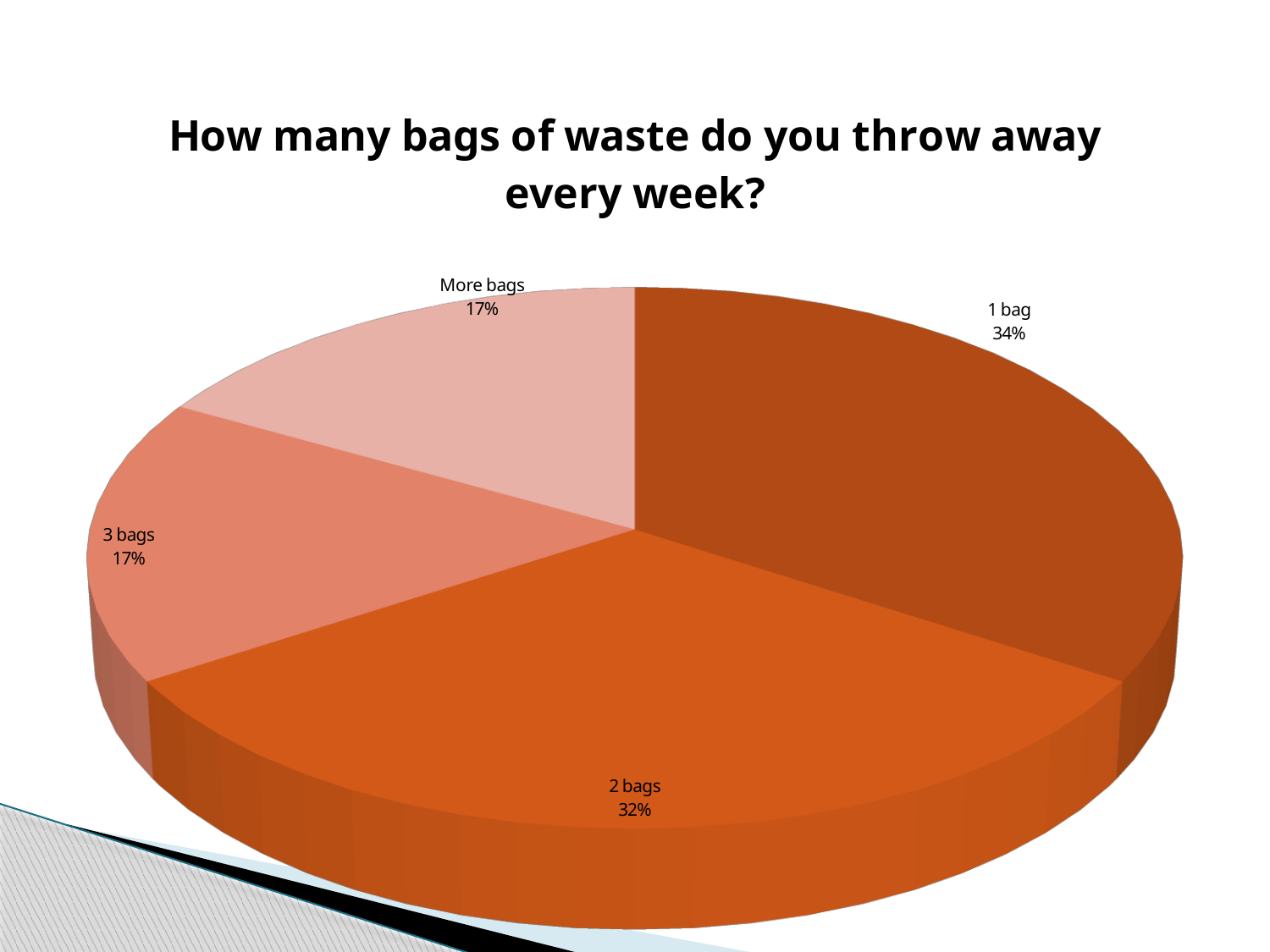
How many categories are shown in the pie chart? 4 Which two categories have the same share of the pie? 3 bags and More bags What share of the pie does the "2 bags" slice represent? 32% What is the difference in percentage points between the "1 bag" slice and the "2 bags" slice? 2 What kind of chart is shown on the slide? Pie chart What share of the pie does the "1 bag" slice represent? 34% Which is larger, the "2 bags" slice or the "More bags" slice? 2 bags What is the title of the chart? How many bags of waste do you throw away every week? Which category has the largest slice of the pie? 1 bag What is the difference in percentage points between the "1 bag" slice and the "3 bags" slice? 17 What share of the pie does the "More bags" slice represent? 17%